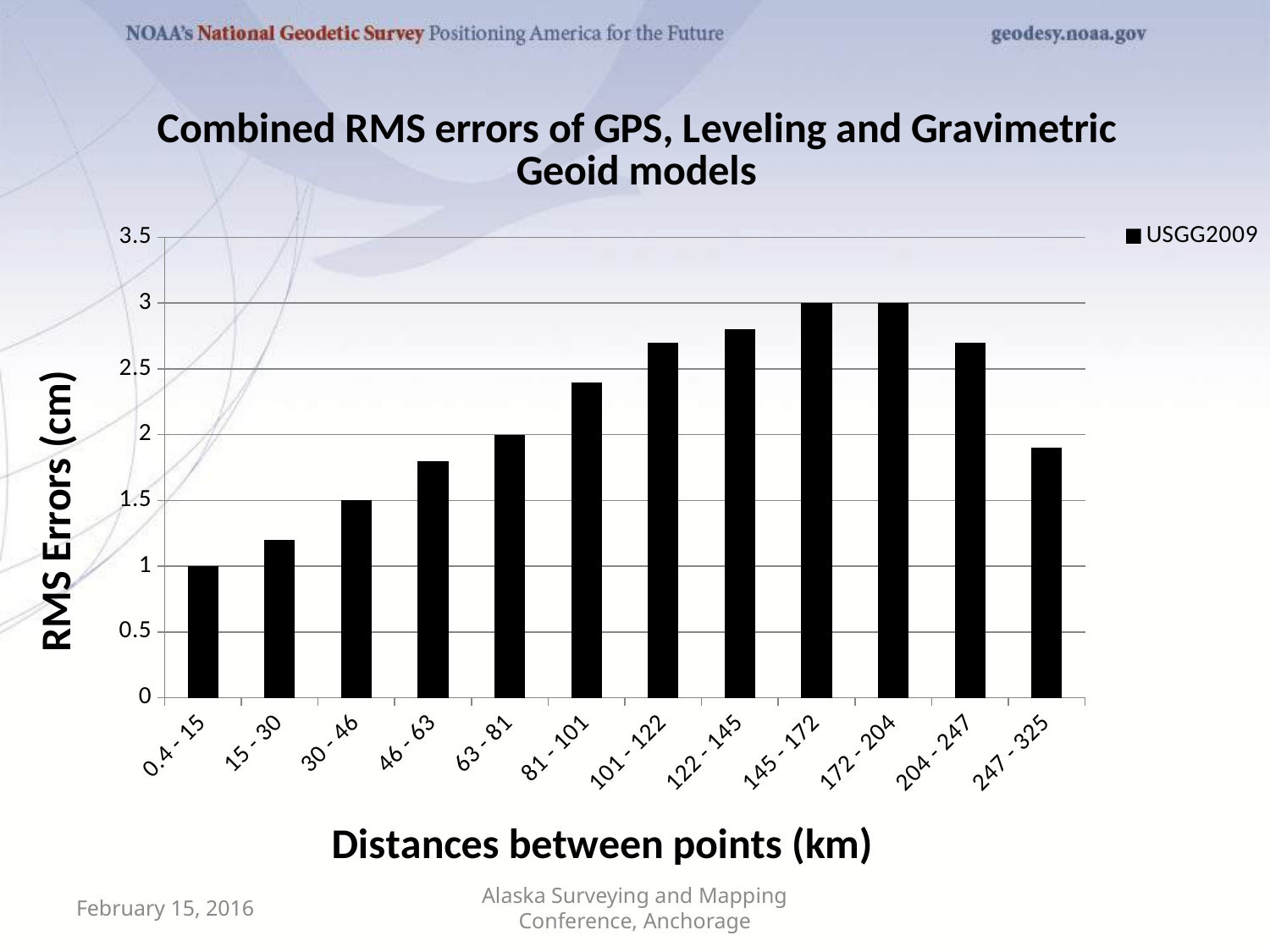
Is the RMS error for the 101 - 122 km bin greater or less than 2.5? greater What is the RMS error value for the 63 - 81 km distance bin? 2 Which has a larger RMS error, the 81 - 101 km bin or the 247 - 325 km bin? 81 - 101 Is the RMS error for the 15 - 30 km bin greater or less than 1.5? less What kind of chart is shown on the slide? Bar chart How many distance bins are shown on the x axis? 12 What is the difference in RMS error between the 63 - 81 km bin and the 0.4 - 15 km bin? 1 What is the RMS error value for the 145 - 172 km distance bin? 3 How many series does the legend list? 1 What is the RMS error value for the 30 - 46 km distance bin? 1.5 What is the RMS error value for the 0.4 - 15 km distance bin? 1 Which distance bin has the lowest RMS error? 0.4 - 15